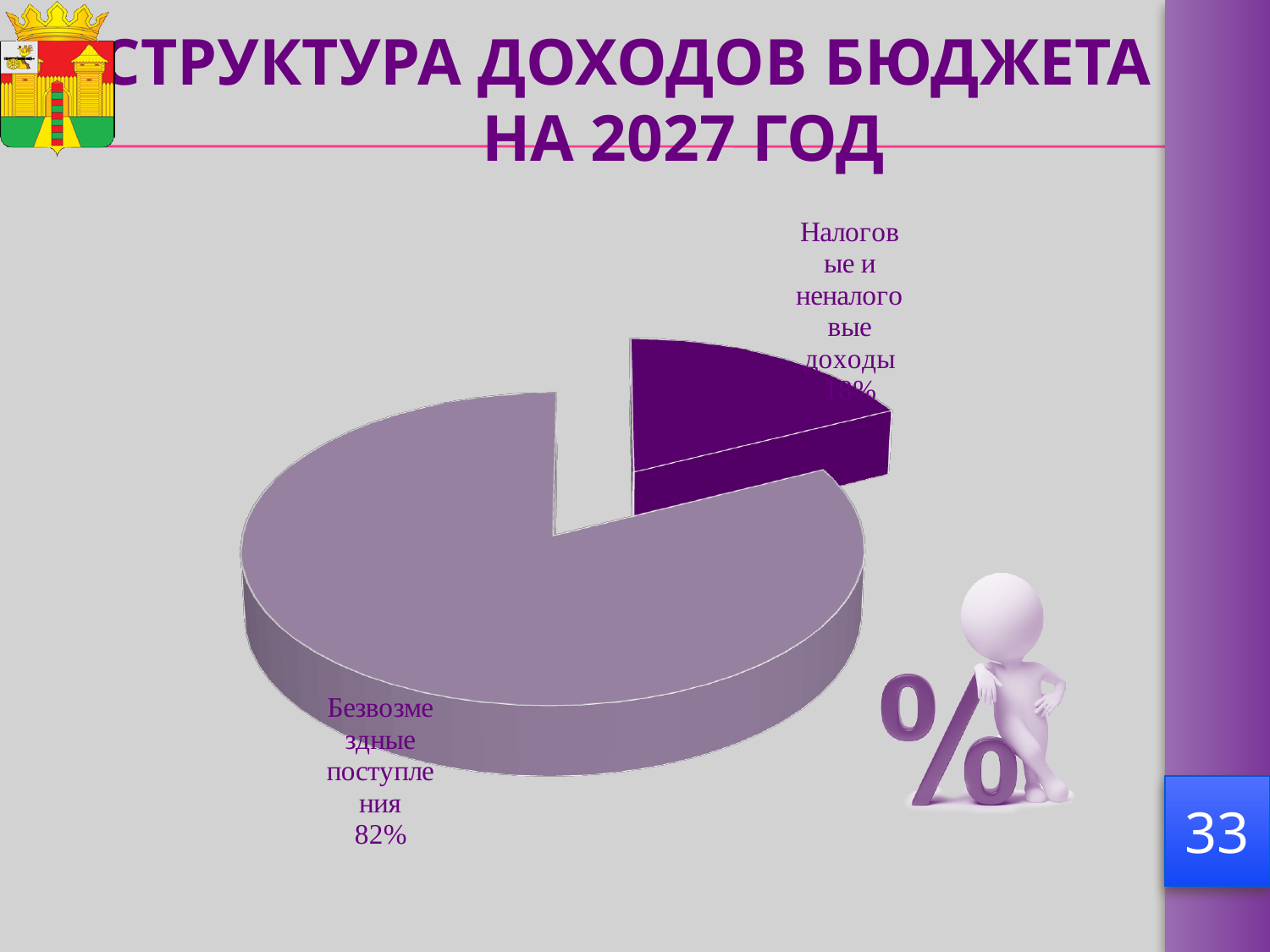
What share of the budget revenue is 'Безвозмездные поступления'? 82% Which is larger: 'Безвозмездные поступления' or 'Налоговые и неналоговые доходы'? Безвозмездные поступления Which slice is shown in the darker purple colour? Налоговые и неналоговые доходы Which category has the largest share of the pie? Безвозмездные поступления What share of the budget revenue is 'Налоговые и неналоговые доходы'? 18% What kind of chart is shown on the slide? pie chart How many slices does the pie chart have? 2 By how many percentage points does 'Безвозмездные поступления' exceed 'Налоговые и неналоговые доходы'? 64 percentage points What is the title of the slide containing the pie chart? СТРУКТУРА ДОХОДОВ БЮДЖЕТА НА 2027 ГОД Which category has the smallest share of the pie? Налоговые и неналоговые доходы